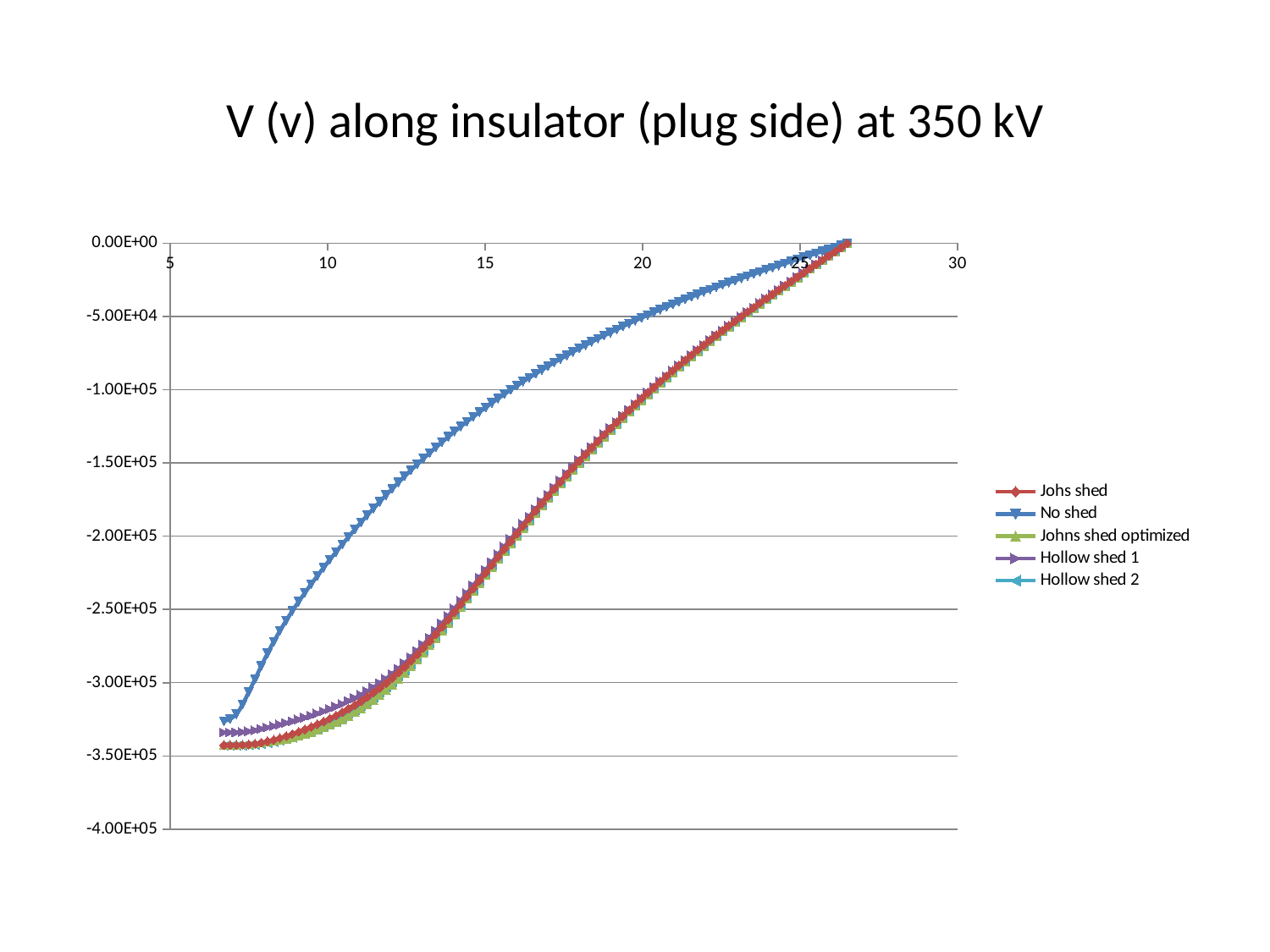
Is the value of the Johs shed series at x = 10 greater or less than -3.00E+05? less What kind of chart is shown on the slide? line chart Is the value of the Hollow shed 1 series at x = 15 greater or less than -2.00E+05? less Which series is plotted in blue with downward-pointing triangle markers? No shed How many series does the legend list? 5 What is the lowest value shown on the y axis? -4.00E+05 What is the title of the chart? V (v) along insulator (plug side) at 350 kV At x = 15, which series has the higher value, No shed or Johs shed? No shed Do the values of the No shed series rise or fall as x increases from left to right? rise Which series has the highest (least negative) value at the left end of the chart? No shed Is the value of the No shed series at x = 20 greater or less than -1.00E+05? greater